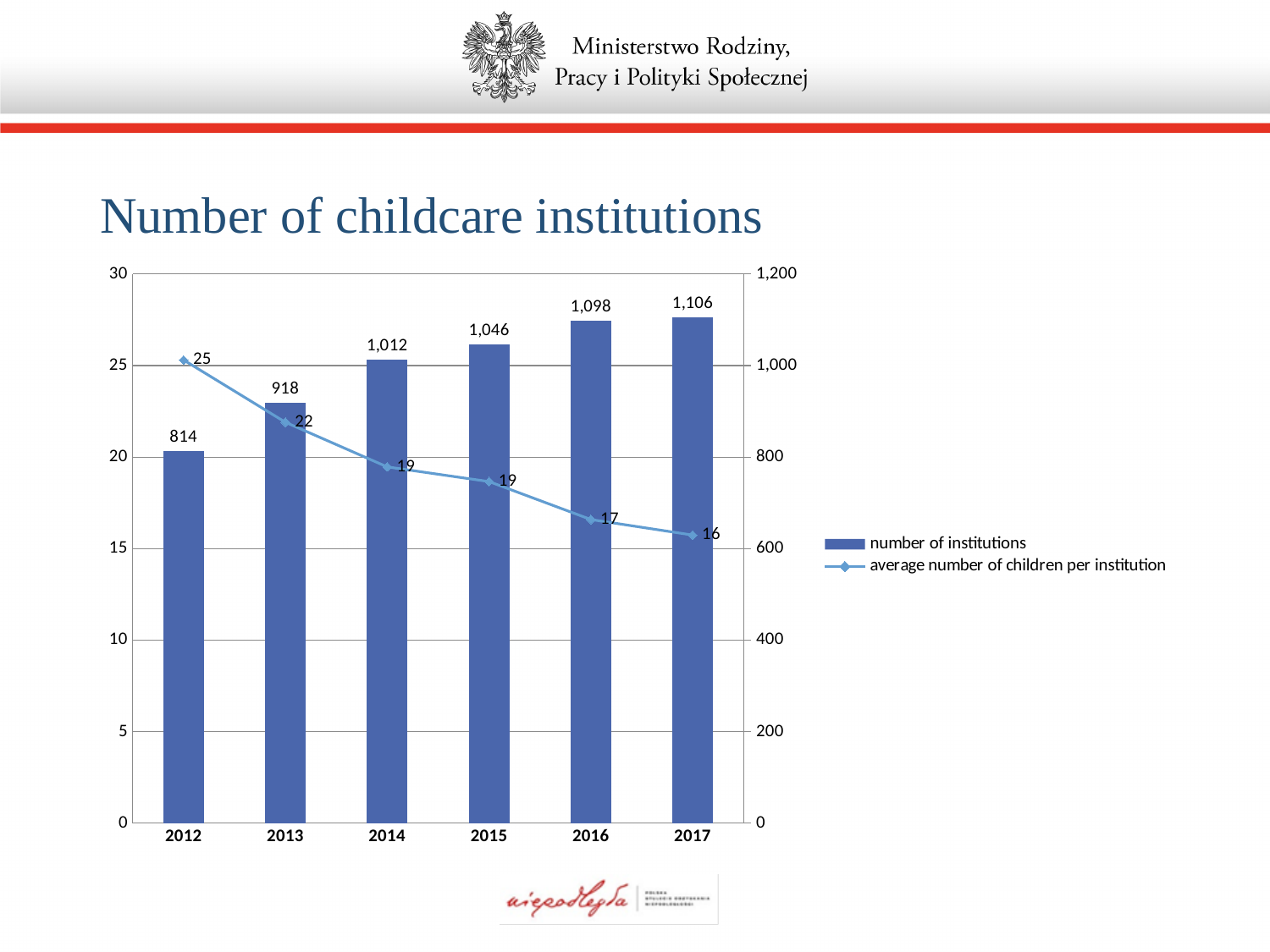
Does the average number of children per institution rise or fall from 2012 to 2017? fall How many series does the legend list? 2 Which year has the lowest number of institutions? 2012 What is the average number of children per institution in 2012? 25 Which series is shown as a line with markers? average number of children per institution Which year has the highest average number of children per institution? 2012 How many years are shown on the x axis? 6 What is the difference in the number of institutions between 2017 and 2012? 292 What is the number of institutions in 2014? 1,012 What is the number of institutions in 2017? 1,106 Which year has more institutions, 2013 or 2015? 2015 What is the title of the chart? Number of childcare institutions